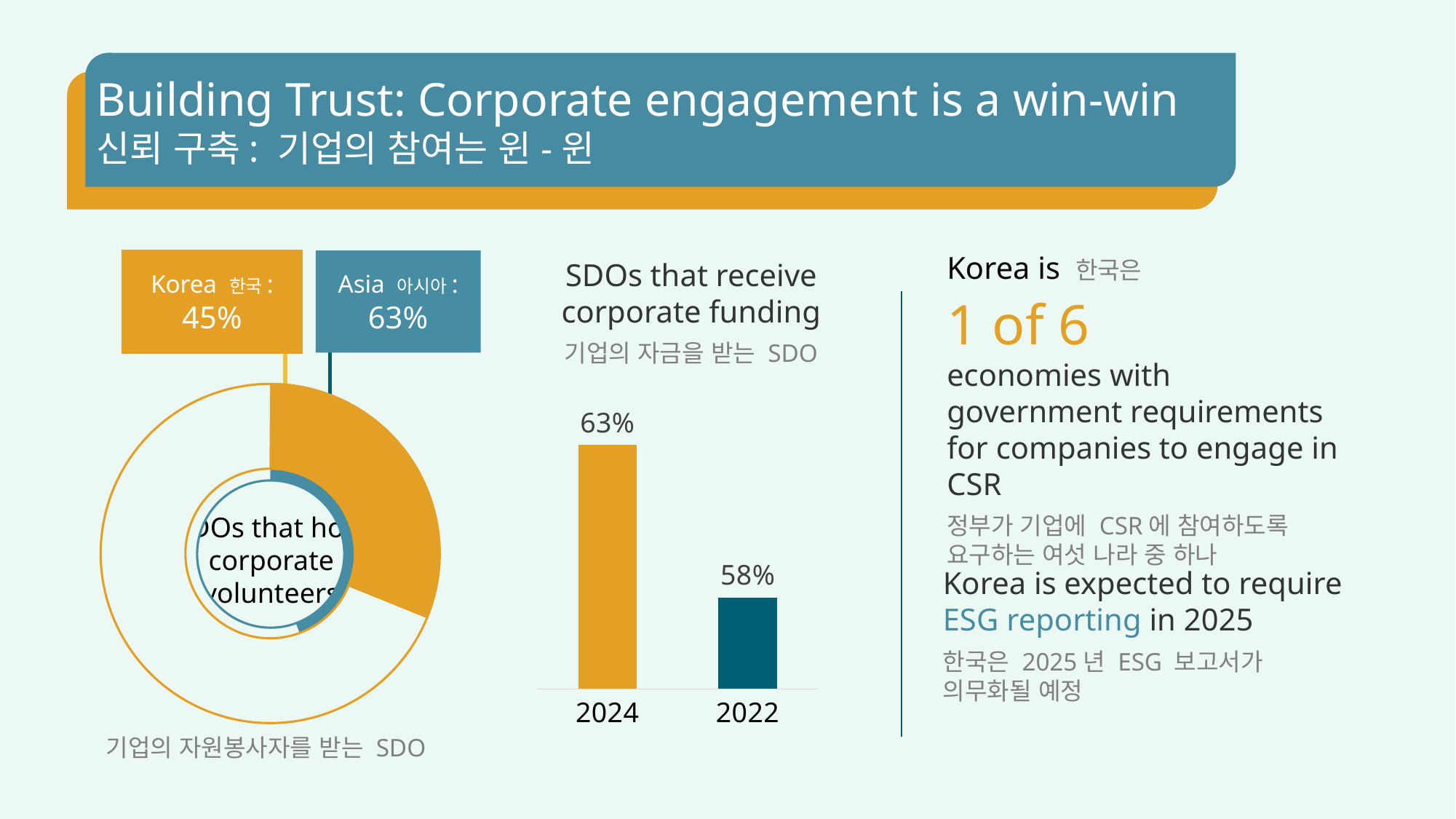
In the 'SDOs that receive corporate funding' chart, what is the value for 2022? 58% In the 'SDOs that receive corporate funding' chart, which year has the lower value? 2022 In the donut chart on the left about SDOs that host corporate volunteers, which is larger, Korea or Asia? Asia What kind of chart is the 'SDOs that receive corporate funding' chart? Bar chart In the donut chart on the left about SDOs that host corporate volunteers, what is the difference between the Asia and Korea values? 18% In the donut chart on the left about SDOs that host corporate volunteers, what is the value for Korea? 45% In the donut chart on the left about SDOs that host corporate volunteers, what is the value for Asia? 63% In the 'SDOs that receive corporate funding' chart, how many bars are shown? 2 In the 'SDOs that receive corporate funding' chart, what is the difference between the 2024 and 2022 values? 5% In the 'SDOs that receive corporate funding' chart, which year has the higher value? 2024 In the 'SDOs that receive corporate funding' chart, what is the value for 2024? 63% In the donut chart on the left, which colour represents Korea? Orange